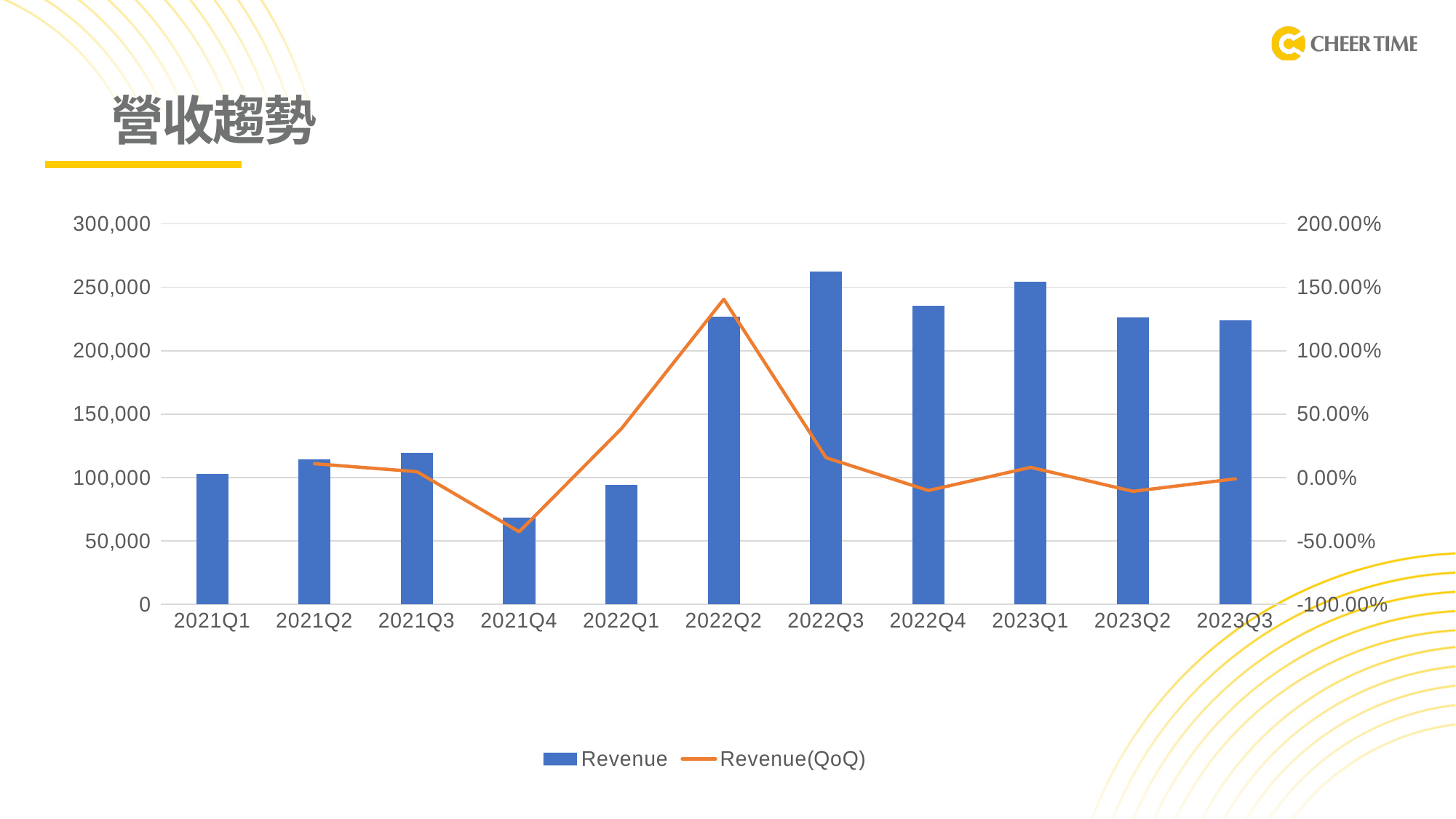
Is the Revenue(QoQ) value for 2021Q4 greater or less than 0.00%? less Is the Revenue(QoQ) value for 2022Q2 greater or less than 100.00%? greater Is the Revenue for 2022Q3 greater or less than 250,000? greater What are the two series named in the chart legend? Revenue and Revenue(QoQ) Which quarter has the larger Revenue, 2022Q2 or 2022Q3? 2022Q3 Does Revenue rise or fall from 2022Q1 to 2022Q3? rise What type of chart is shown on the slide? A combination bar and line chart How many quarters are shown on the x axis of the chart? 11 Which quarter has the lowest Revenue bar? 2021Q4 Which quarter has the highest Revenue bar? 2022Q3 How many series does the chart legend list? 2